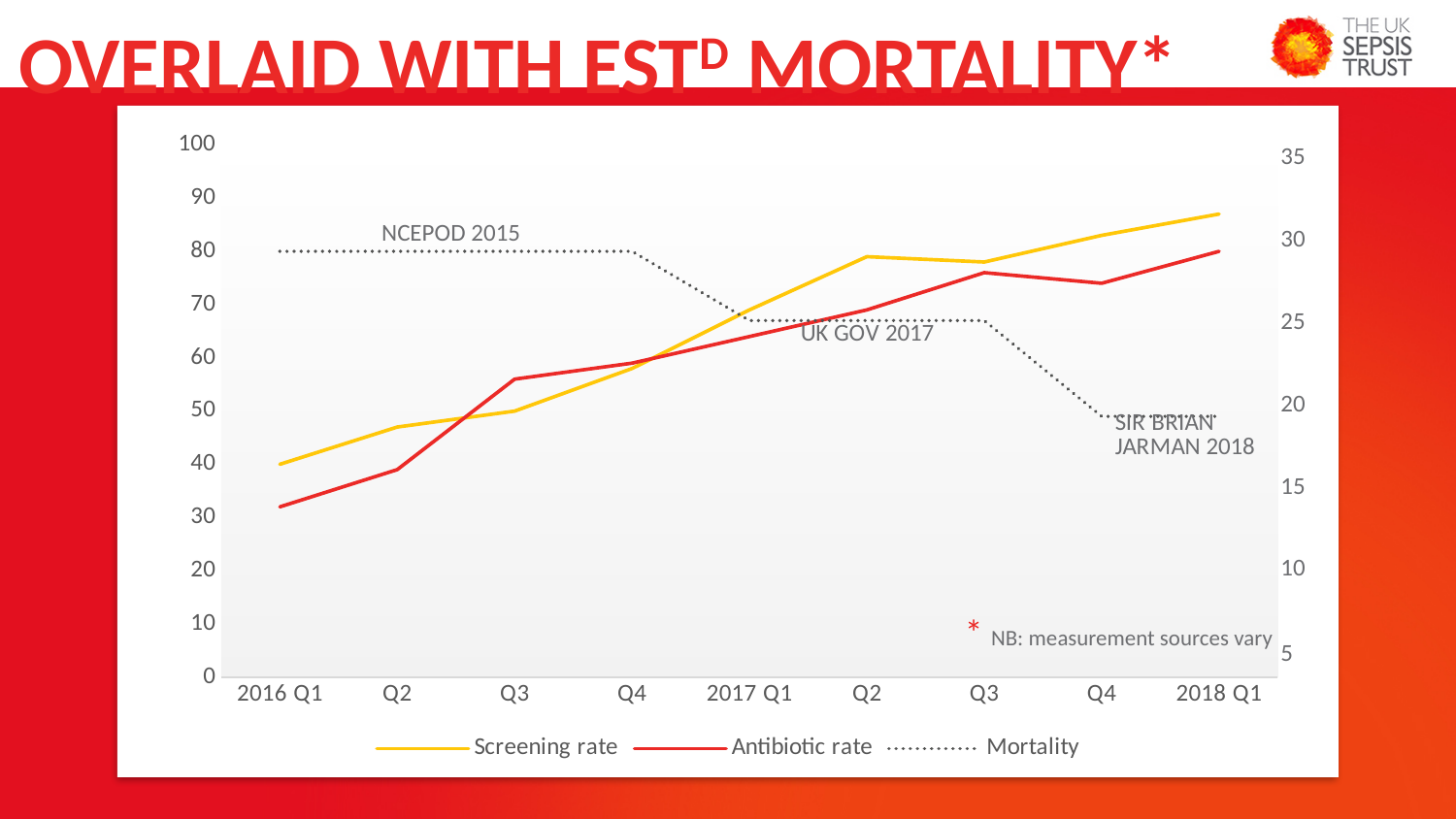
Is the Screening rate at 2018 Q1 greater or less than 80? greater In which quarter is the Antibiotic rate lowest? 2016 Q1 Does the Screening rate generally rise or fall from 2016 Q1 to 2018 Q1? Rise Which series in the legend is drawn as a dotted line? Mortality Is the Antibiotic rate at 2016 Q1 greater or less than 40? less Does the Mortality line rise or fall across the chart? Fall How many quarters are shown along the x axis of the chart? 9 In which quarter is the Screening rate highest? 2018 Q1 What kind of chart is shown on the slide? Line chart How many series does the chart legend list? 3 At 2017 Q2, which is higher: the Screening rate or the Antibiotic rate? Screening rate At 2016 Q3, which is higher: the Screening rate or the Antibiotic rate? Antibiotic rate